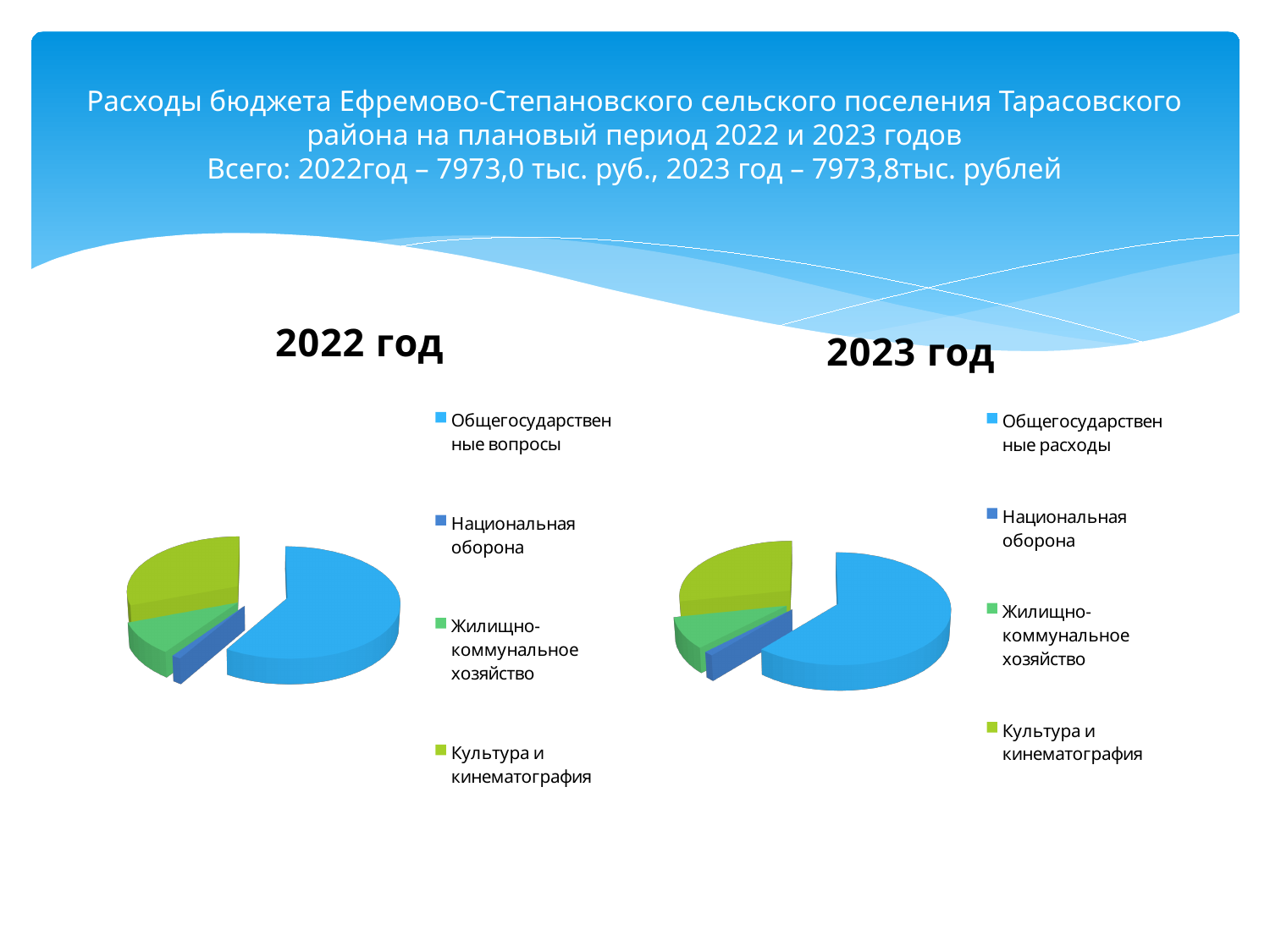
In the "2023 год" pie chart, which slice is larger: Общегосударственные расходы or Культура и кинематография? Общегосударственные расходы In the "2022 год" pie chart, which slice is larger: Культура и кинематография or Жилищно-коммунальное хозяйство? Культура и кинематография In the "2023 год" pie chart, which category has the smallest slice? Национальная оборона In the "2022 год" pie chart, which category has the smallest slice? Национальная оборона In the "2023 год" pie chart, which category has the largest slice? Общегосударственные расходы What type of chart is the "2023 год" chart? pie chart What type of chart is the "2022 год" chart? pie chart How many slices does the "2022 год" pie chart have? 4 How many entries does the legend of the "2022 год" chart list? 4 In the "2022 год" pie chart, which category has the largest slice? Общегосударственные вопросы How many slices does the "2023 год" pie chart have? 4 In the "2022 год" chart, what colour is the slice for Культура и кинематография? yellow-green